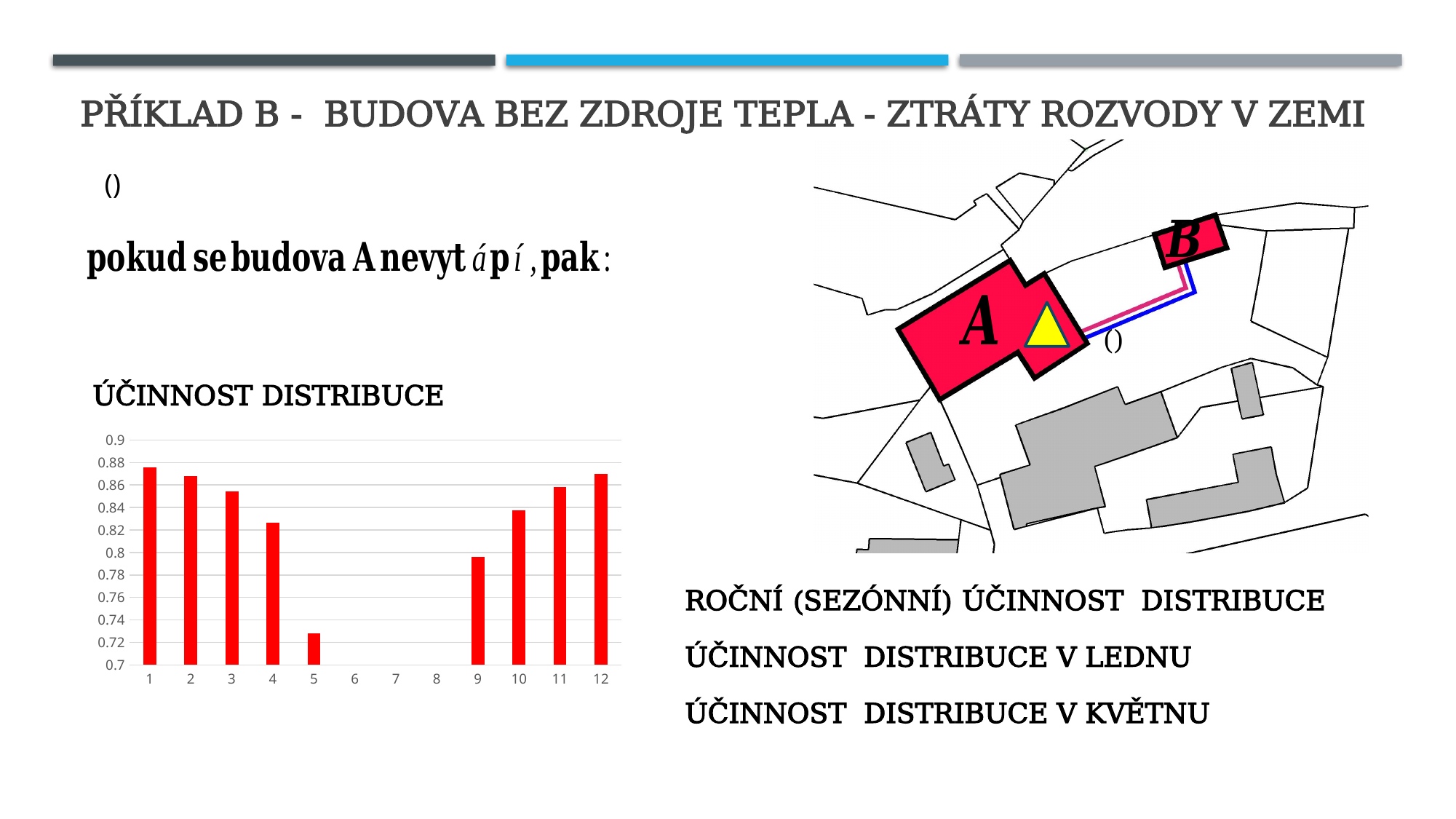
Is the value for month 9 greater or less than 0.78? greater Is the value for month 4 greater or less than 0.84? less Do the values rise or fall from month 9 to month 12 in the ÚČINNOST DISTRIBUCE chart? rise Which is larger, the value for month 9 or the value for month 4? month 4 Which is larger, the value for month 2 or the value for month 5? month 2 For how many of the months on the x axis does the ÚČINNOST DISTRIBUCE chart show a bar? 9 What is the title of the chart on the slide? ÚČINNOST DISTRIBUCE Is the value for month 5 greater or less than 0.74? less Which month has the lowest bar in the ÚČINNOST DISTRIBUCE chart? 5 How many categories are labelled on the x axis of the ÚČINNOST DISTRIBUCE chart? 12 What kind of chart is shown under the heading ÚČINNOST DISTRIBUCE? bar chart